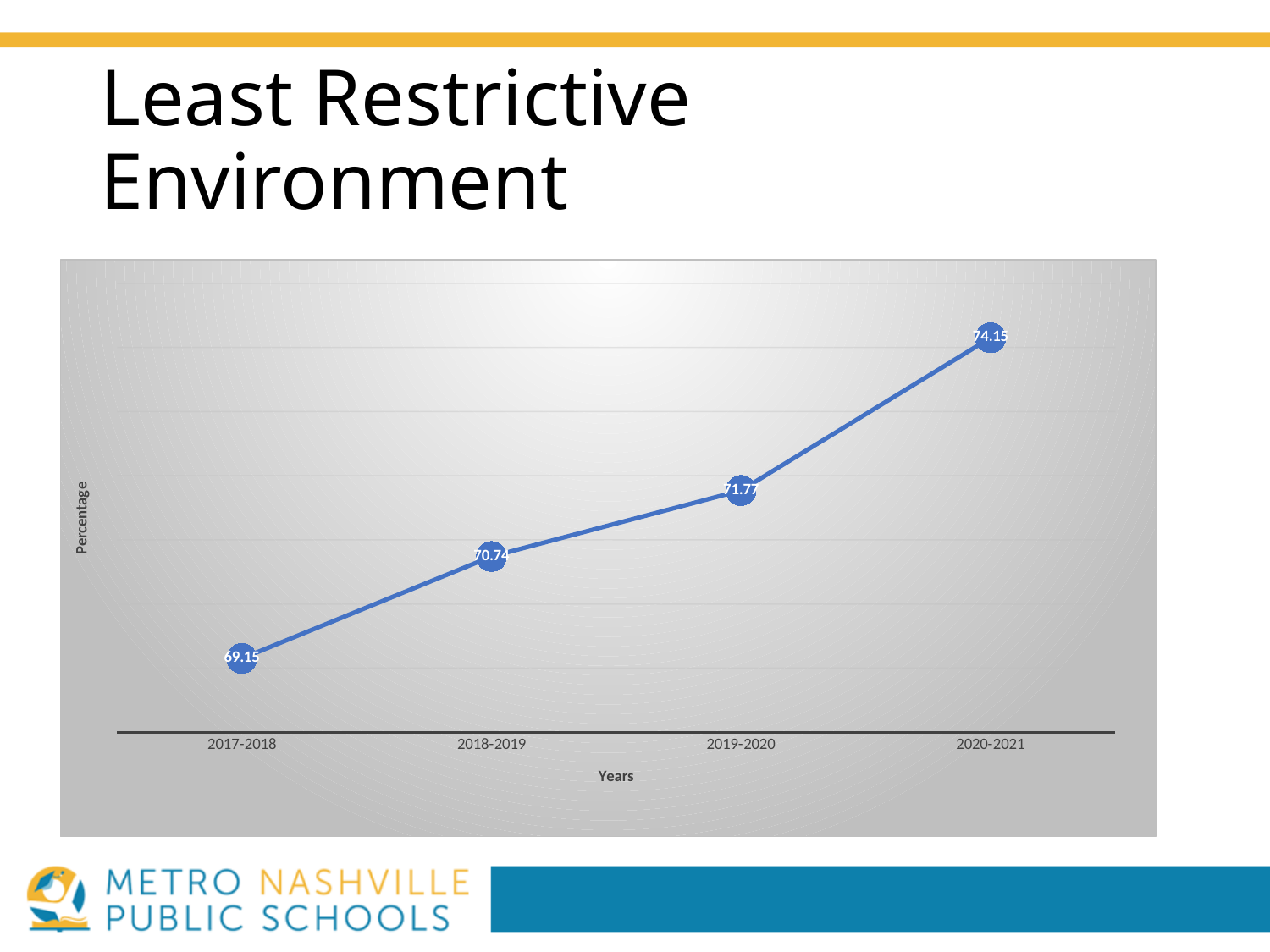
How many data points are plotted on the chart? 4 What kind of chart is shown on the slide? Line chart What is the value for 2020-2021? 74.15 Which is larger, the value for 2018-2019 or the value for 2019-2020? 2019-2020 Which year has the lowest value? 2017-2018 What is the difference between the values for 2020-2021 and 2017-2018? 5 What is the value for 2018-2019? 70.74 Do the values rise or fall from 2017-2018 to 2020-2021? Rise What is the difference between the values for 2019-2020 and 2018-2019? 1.03 What is the value for 2017-2018? 69.15 What is the value for 2019-2020? 71.77 Which year has the highest value? 2020-2021